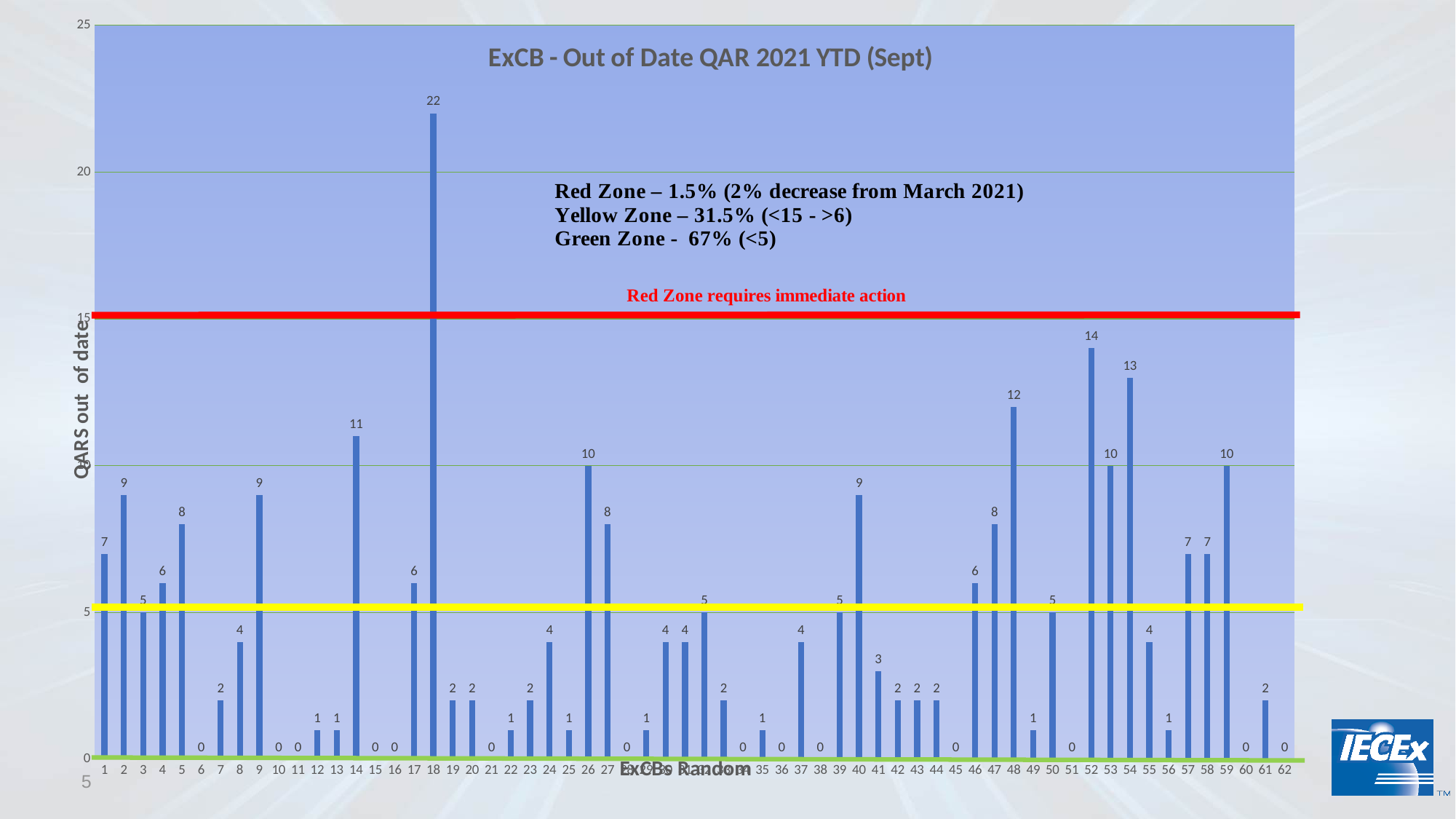
Which is larger, the value for ExCB 48 or the value for ExCB 54? ExCB 54 What is the value for ExCB 18? 22 What is the difference between the values for ExCB 26 and ExCB 27? 2 What is the label of the y axis? QARS out of date What type of chart is shown on the slide? bar chart What is the value for ExCB 41? 3 Which ExCB has the highest number of QARs out of date? 18 What is the difference between the values for ExCB 18 and ExCB 52? 8 What is the value for ExCB 52? 14 What is the value for ExCB 14? 11 What is the title of the chart? ExCB - Out of Date QAR 2021 YTD (Sept) Is the value for ExCB 18 greater or less than 20? greater